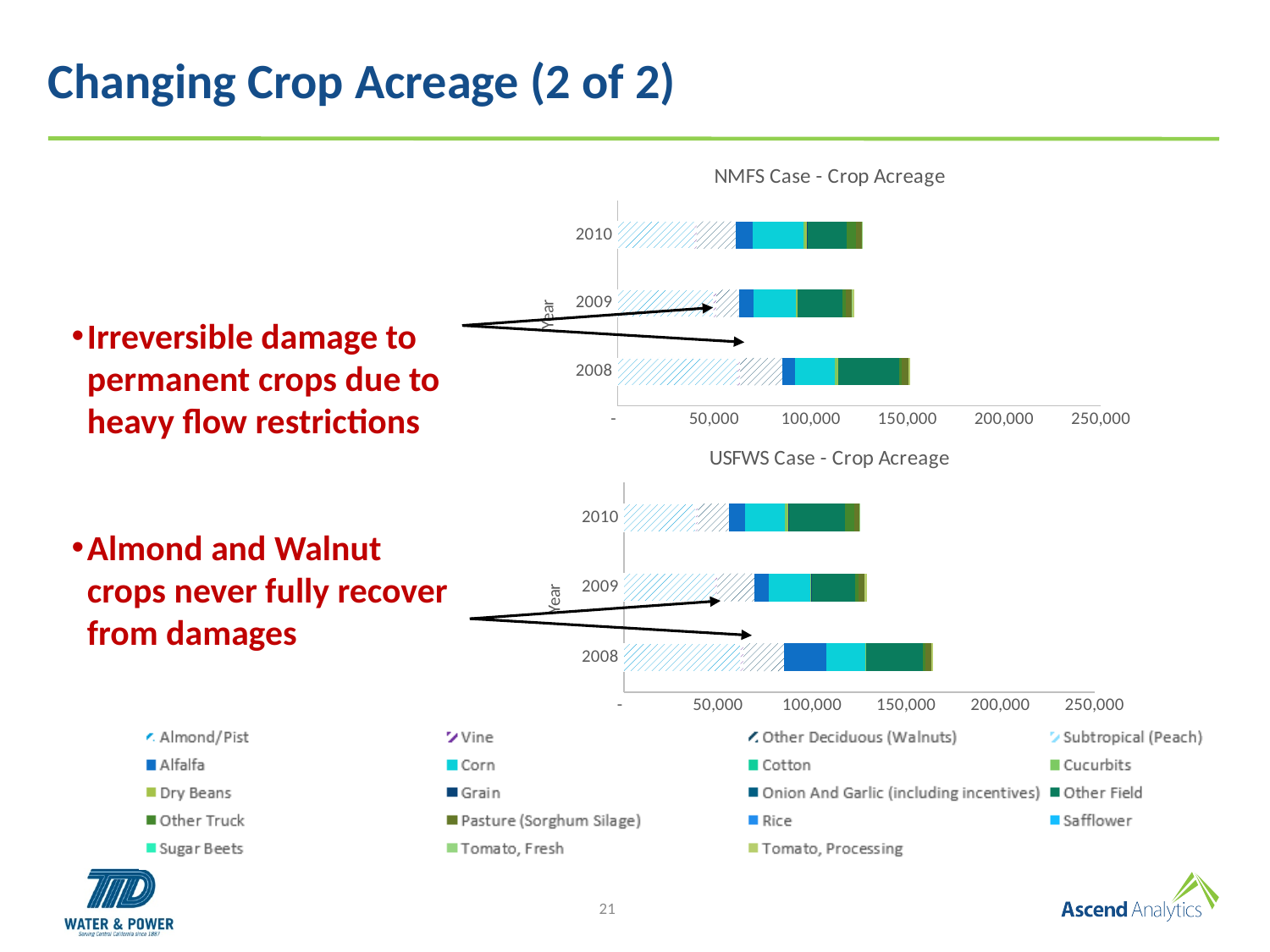
In the NMFS Case - Crop Acreage chart, which year has the larger total acreage, 2008 or 2010? 2008 What type of chart is the NMFS Case - Crop Acreage chart? Stacked bar chart In the USFWS Case - Crop Acreage chart, is the total acreage for 2010 greater or less than 150,000? less In the NMFS Case - Crop Acreage chart, is the total acreage for 2009 greater or less than 100,000? greater What is the label on the vertical axis of the USFWS Case - Crop Acreage chart? Year In the USFWS Case - Crop Acreage chart, is the total acreage for 2009 greater or less than 100,000? greater In the NMFS Case - Crop Acreage chart, which year has the largest total crop acreage? 2008 What is the title of the upper chart on the slide? NMFS Case - Crop Acreage How many years are plotted in the USFWS Case - Crop Acreage chart? 3 In the USFWS Case - Crop Acreage chart, which year has the largest total crop acreage? 2008 How many crop categories does the shared legend list? 19